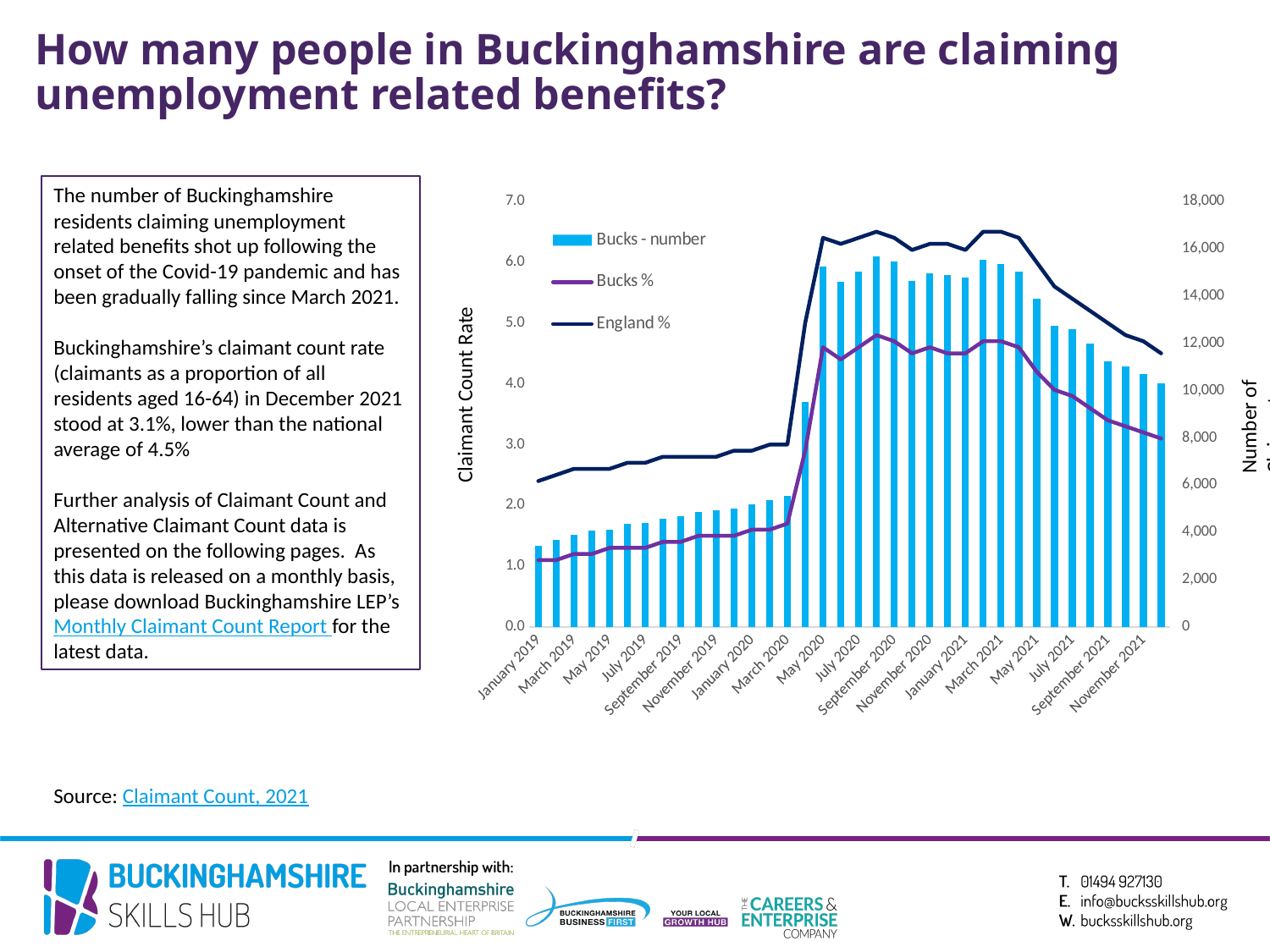
Is the England % value for January 2019 greater or less than 3.0? less Is the Bucks % value for November 2021 greater or less than 4.0? less Which series in the chart is plotted as bars? Bucks - number Is the Bucks - number value for May 2020 greater or less than 14,000? greater What kind of chart is shown on the slide? A combined bar and line chart How many series does the chart legend list? 3 What is the title of the left vertical axis? Claimant Count Rate Which month has the lowest Bucks - number value? January 2019 In November 2021, which is higher, England % or Bucks %? England % Do the Bucks - number values rise or fall from March 2021 to November 2021? fall